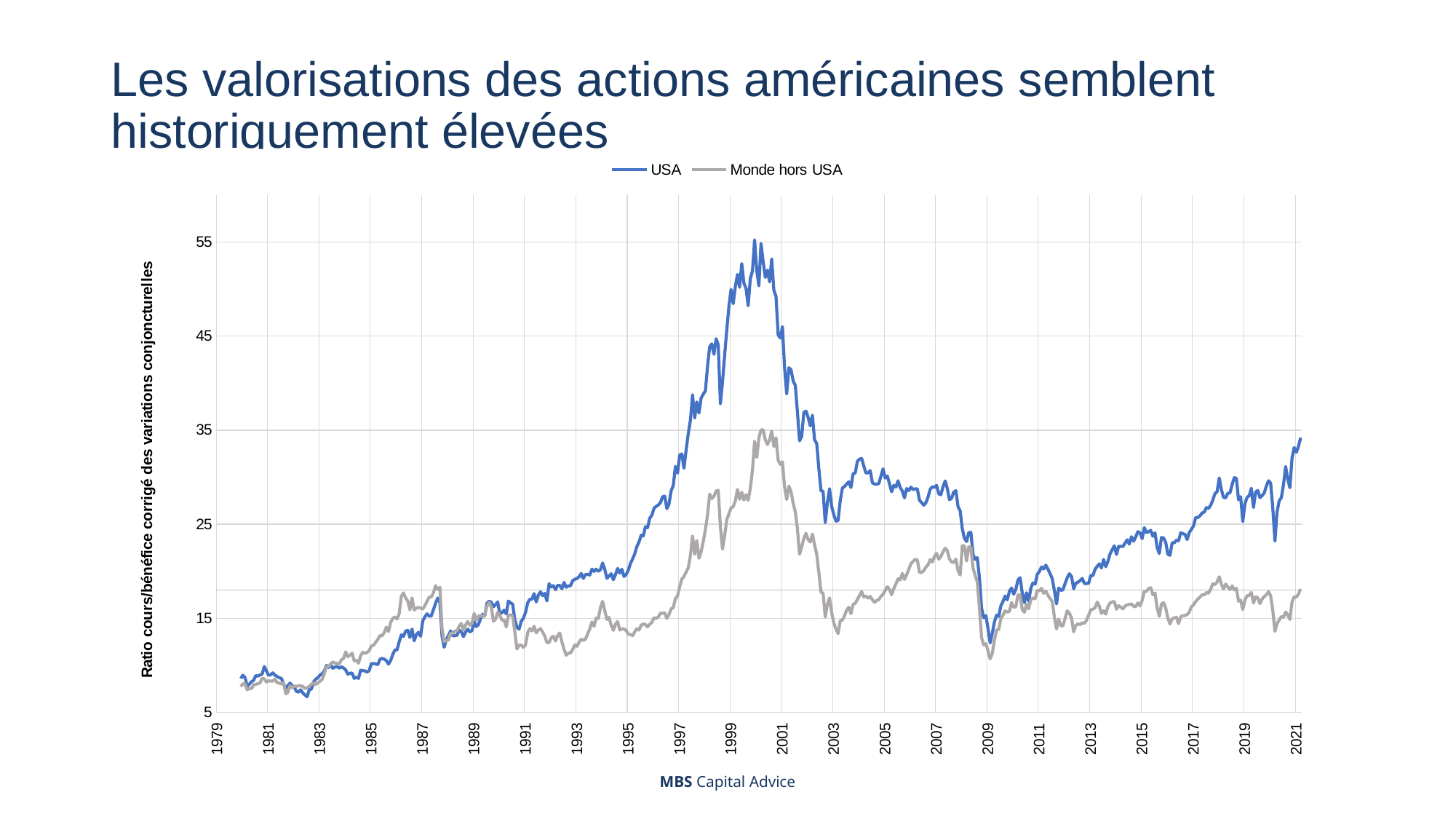
Which series is higher at the end of the chart in 2021, USA or Monde hors USA? USA Is the lowest value of the Monde hors USA series around 2009 greater or less than 15? less How many series does the legend list? 2 Is the value of the USA series at the end of the chart in 2021 greater or less than 25? greater Which series reaches the higher peak around 2000, USA or Monde hors USA? USA Is the peak value of the USA series around 2000 greater or less than 45? greater What kind of chart is shown on the slide? line chart Does the USA series generally rise or fall between 2009 and 2021? rise What is the label of the vertical axis? Ratio cours/bénéfice corrigé des variations conjoncturelles What are the two series named in the legend? USA and Monde hors USA